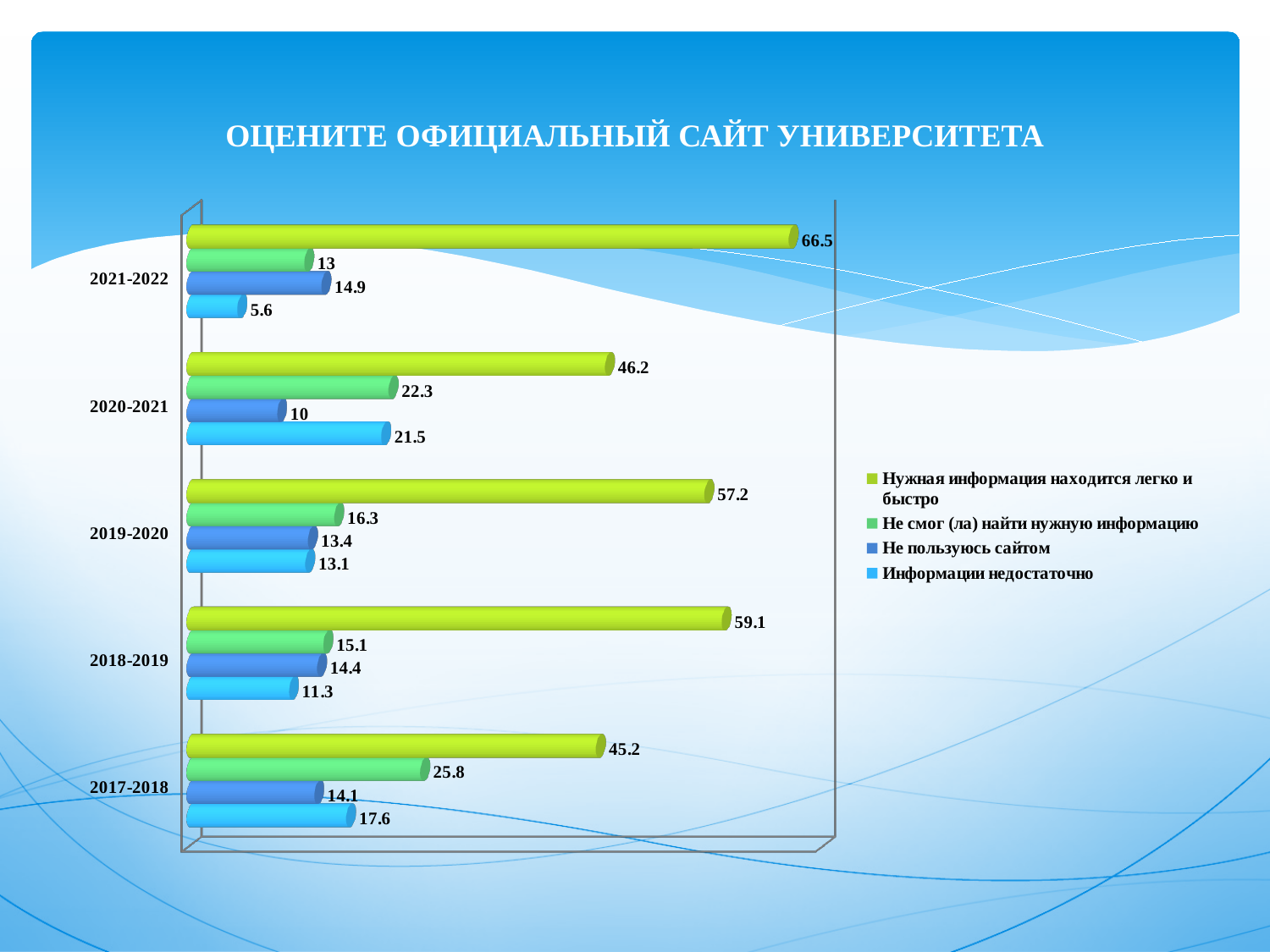
In which year is the value for "Нужная информация находится легко и быстро" the highest? 2021-2022 What is the difference between the "Нужная информация находится легко и быстро" values for 2021-2022 and 2020-2021? 20.3 How many series does the legend list? 4 Which is larger in 2017-2018: "Не смог (ла) найти нужную информацию" or "Информации недостаточно"? Не смог (ла) найти нужную информацию What is the value for "Не смог (ла) найти нужную информацию" in 2019-2020? 16.3 In which year is the value for "Информации недостаточно" the lowest? 2021-2022 What is the title of the slide? ОЦЕНИТЕ ОФИЦИАЛЬНЫЙ САЙТ УНИВЕРСИТЕТА What is the value for "Не пользуюсь сайтом" in 2017-2018? 14.1 What is the value for "Информации недостаточно" in 2020-2021? 21.5 What type of chart is shown on the slide? Bar chart How many year categories are shown on the chart? 5 What is the value for "Нужная информация находится легко и быстро" in 2021-2022? 66.5